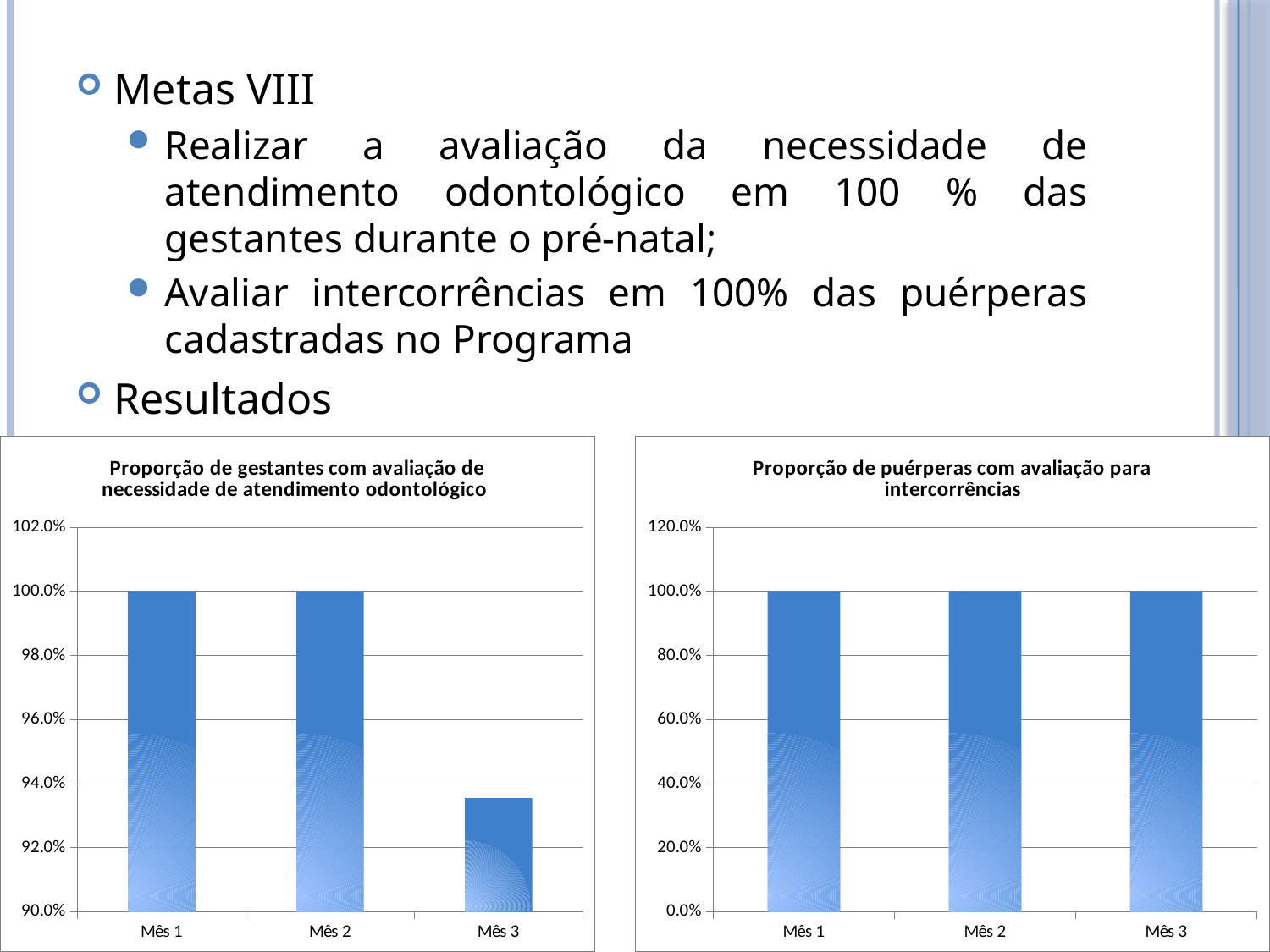
In the chart titled 'Proporção de gestantes com avaliação de necessidade de atendimento odontológico', how many months are shown on the x axis? 3 In the chart titled 'Proporção de gestantes com avaliação de necessidade de atendimento odontológico', is the value for Mês 3 greater or less than 92.0%? greater In the chart titled 'Proporção de gestantes com avaliação de necessidade de atendimento odontológico', do the values rise or fall from Mês 2 to Mês 3? fall In the chart titled 'Proporção de puérperas com avaliação para intercorrências', what is the highest value shown on the y axis? 120.0% How many charts are shown on the slide? 2 In the chart titled 'Proporção de puérperas com avaliação para intercorrências', what is the value for Mês 3? 100.0% What kind of chart is the one titled 'Proporção de puérperas com avaliação para intercorrências'? bar chart In the chart titled 'Proporção de gestantes com avaliação de necessidade de atendimento odontológico', which is larger, the value for Mês 2 or Mês 3? Mês 2 In the chart titled 'Proporção de puérperas com avaliação para intercorrências', what is the difference between the values for Mês 1 and Mês 2? 0.0% In the chart titled 'Proporção de gestantes com avaliação de necessidade de atendimento odontológico', what is the value for Mês 1? 100.0% In the chart titled 'Proporção de gestantes com avaliação de necessidade de atendimento odontológico', is the value for Mês 3 greater or less than 94.0%? less In the chart titled 'Proporção de gestantes com avaliação de necessidade de atendimento odontológico', which month has the lowest value? Mês 3